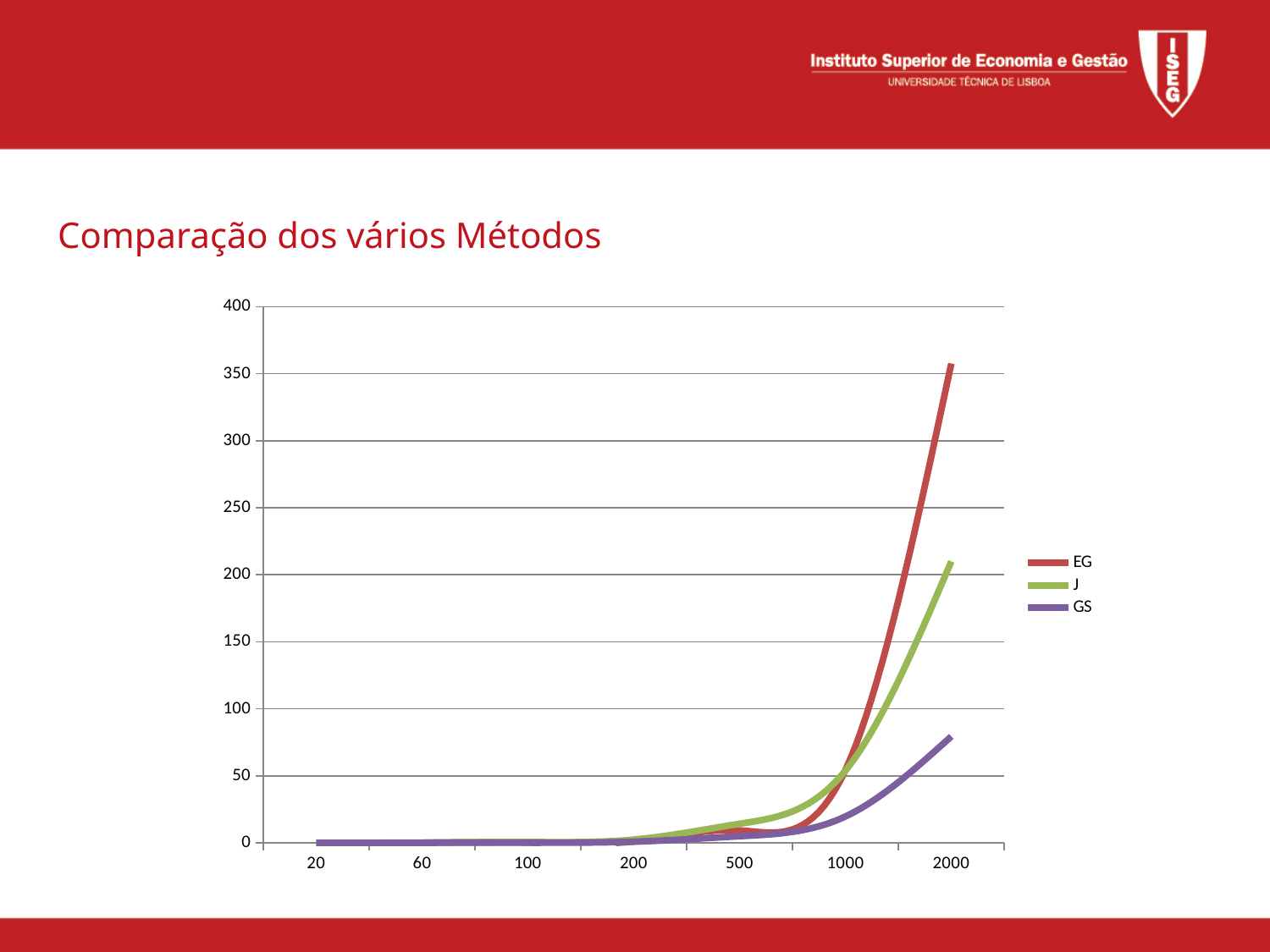
Which series has the lowest value at x = 2000? GS Is the value of GS at x = 2000 greater or less than 100? less Which series has the highest value at x = 2000? EG Do the values of the EG series rise or fall as x increases from 20 to 2000? rise What kind of chart is shown on the slide? line chart What is the title of the slide containing the chart? Comparação dos vários Métodos Is the value of EG at x = 2000 greater or less than 300? greater Is the value of GS at x = 1000 greater or less than 50? less How many points are marked along the x axis? 7 How many series does the legend list? 3 At x = 2000, which is larger, the value of J or the value of GS? J